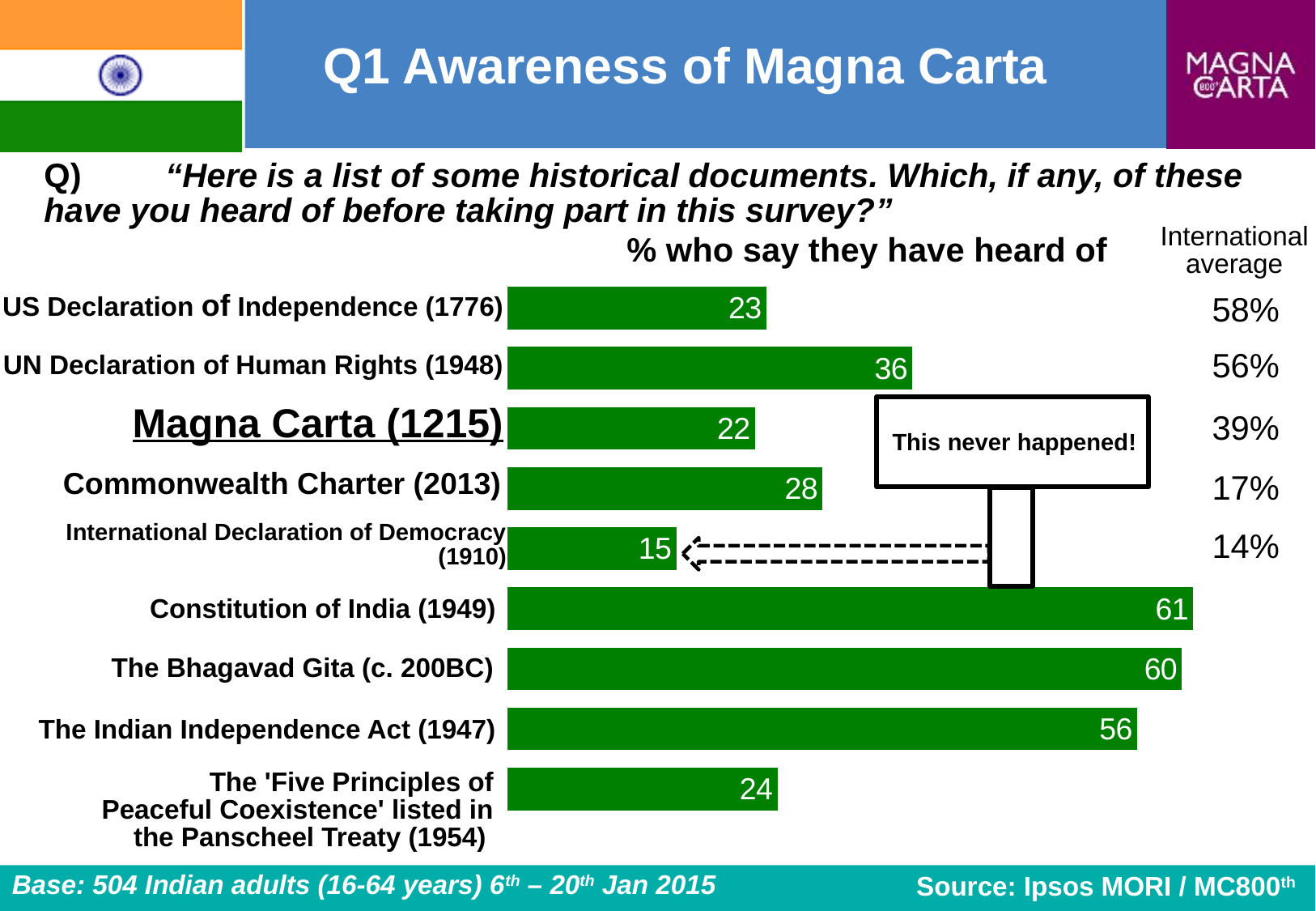
What type of chart is shown on the slide? Bar chart What is the difference between the values for the Constitution of India (1949) and the Magna Carta (1215)? 39 Which document has the highest percentage of respondents who have heard of it? Constitution of India (1949) How many documents are listed as categories in the bar chart? 9 What does the callout box on the chart say? This never happened! What percentage of respondents say they have heard of the Magna Carta (1215)? 22 What is the value shown for the Constitution of India (1949)? 61 Which document has the lowest percentage of respondents who have heard of it? International Declaration of Democracy (1910) Which has a higher value: the Commonwealth Charter (2013) or the US Declaration of Independence (1776)? Commonwealth Charter (2013) What percentage say they have heard of the UN Declaration of Human Rights (1948)? 36 What is the international average shown for the Magna Carta (1215)? 39% What is the value shown for The Indian Independence Act (1947)? 56